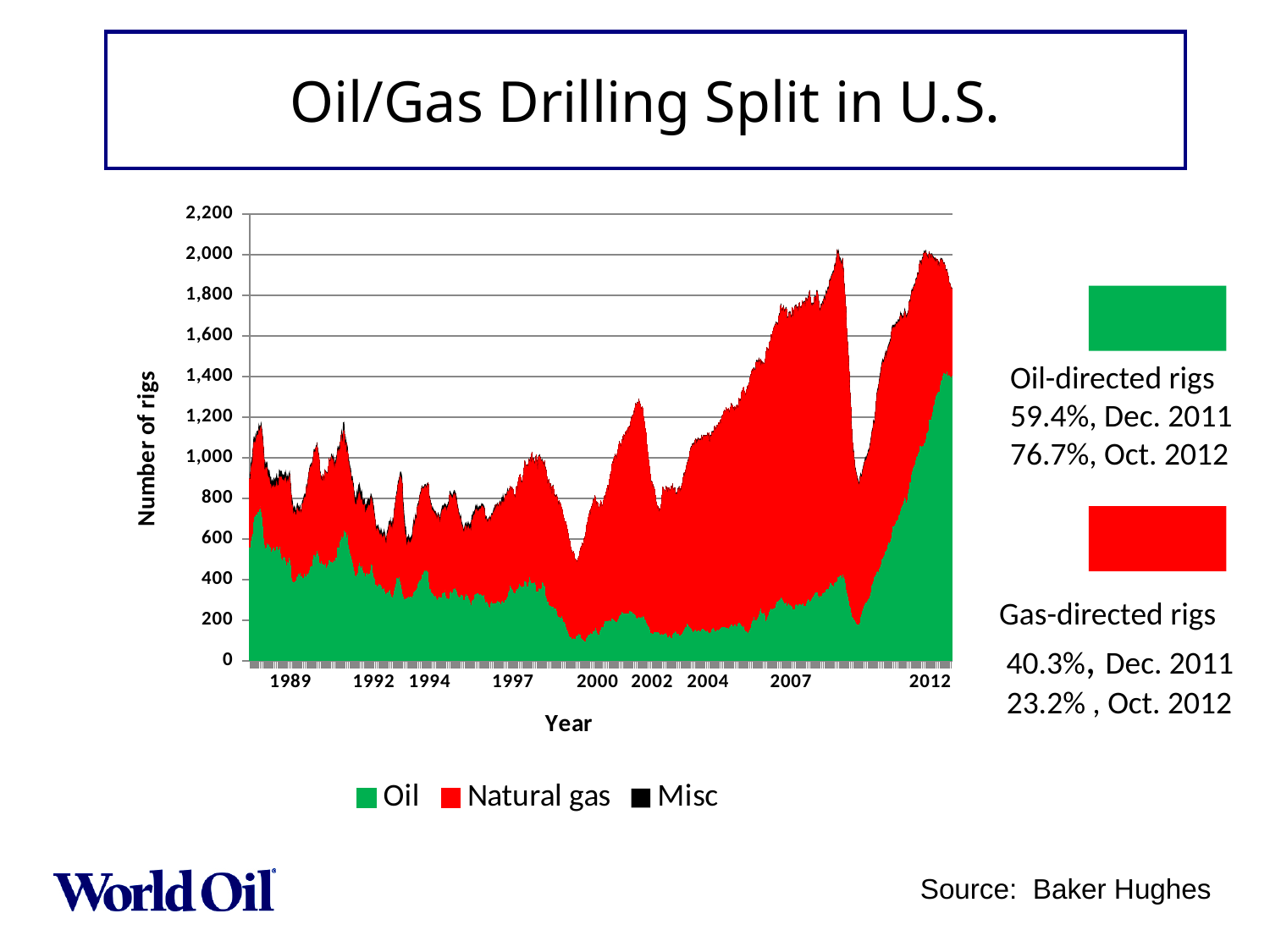
What is the title of the chart on the slide? Oil/Gas Drilling Split in U.S. How many series does the chart legend list? 3 Does the number of Oil rigs rise or fall between 2009 and 2012? Rise Is the number of Oil rigs at the end of 2012 greater or less than 1,000? greater What kind of chart is shown on the slide? Stacked area chart What colour represents the Oil series in the chart? Green By how many percentage points did the oil-directed rig share increase from Dec. 2011 to Oct. 2012? 17.3 According to the annotation, what share of rigs were gas-directed in Dec. 2011? 40.3% Which was larger in Oct. 2012, the share of oil-directed rigs or the share of gas-directed rigs? Oil-directed rigs Is the number of Oil rigs around the year 2000 greater or less than 400? less What is the difference between the oil-directed and gas-directed rig shares in Oct. 2012? 53.5 percentage points According to the annotation, what share of rigs were oil-directed in Oct. 2012? 76.7%